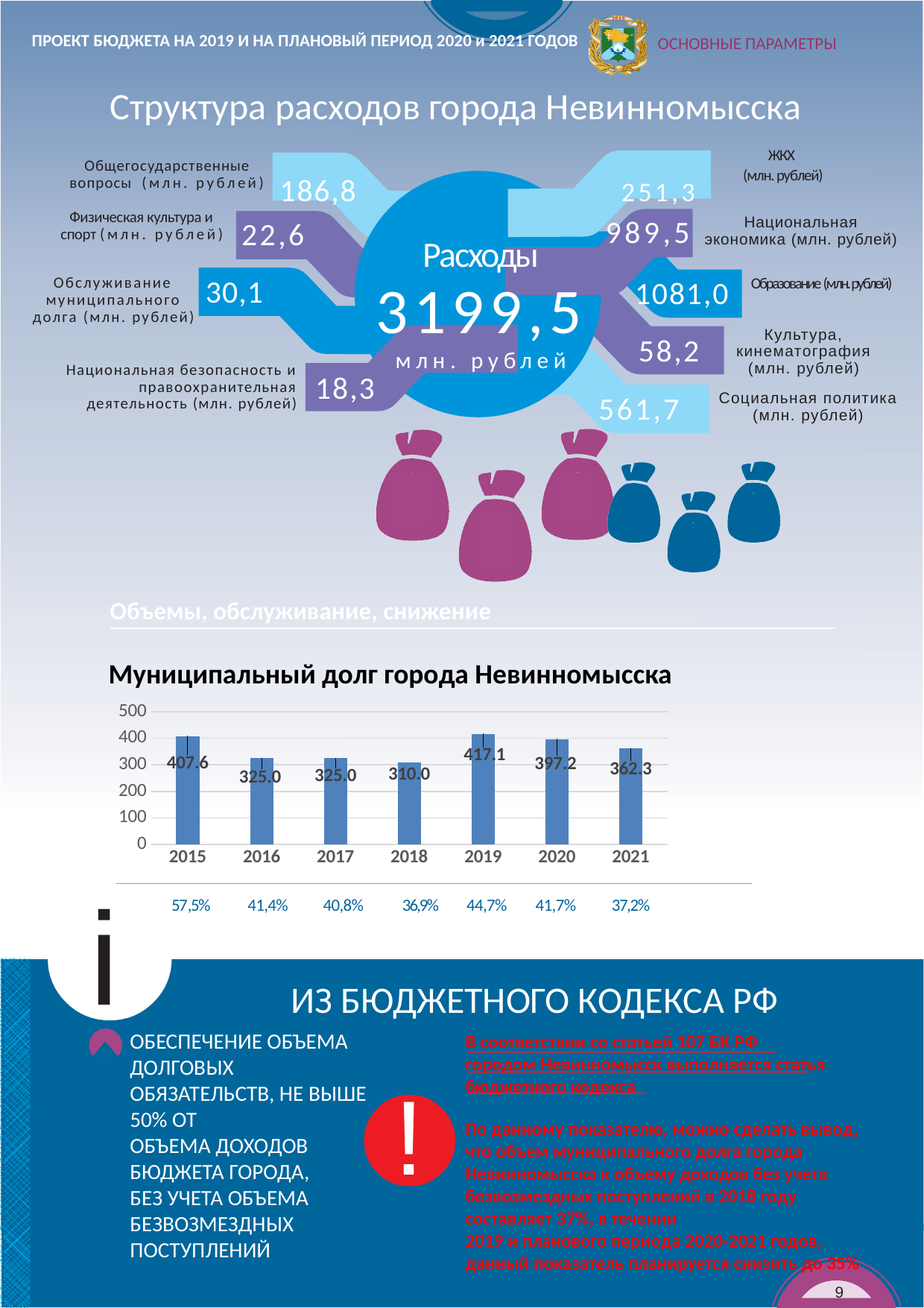
In the chart 'Муниципальный долг города Невинномысска', which year has the lowest value? 2018 In the chart 'Муниципальный долг города Невинномысска', do the values rise or fall from 2019 to 2021? fall In the chart 'Муниципальный долг города Невинномысска', what is the value for 2019? 417.1 In the chart 'Муниципальный долг города Невинномысска', what is the difference between the values for 2015 and 2016? 82.6 How many years are shown on the x axis of the chart 'Муниципальный долг города Невинномысска'? 7 In the chart 'Муниципальный долг города Невинномысска', is the value for 2021 greater or less than 400? less In the chart 'Муниципальный долг города Невинномысска', what is the difference between the values for 2019 and 2018? 107.1 In the chart 'Муниципальный долг города Невинномысска', what is the value for 2018? 310.0 What kind of chart is 'Муниципальный долг города Невинномысска'? bar chart In the chart 'Муниципальный долг города Невинномысска', what is the value for 2021? 362.3 In the chart 'Муниципальный долг города Невинномысска', which year has the highest value? 2019 In the chart 'Муниципальный долг города Невинномысска', which is larger, the value for 2015 or the value for 2020? 2015